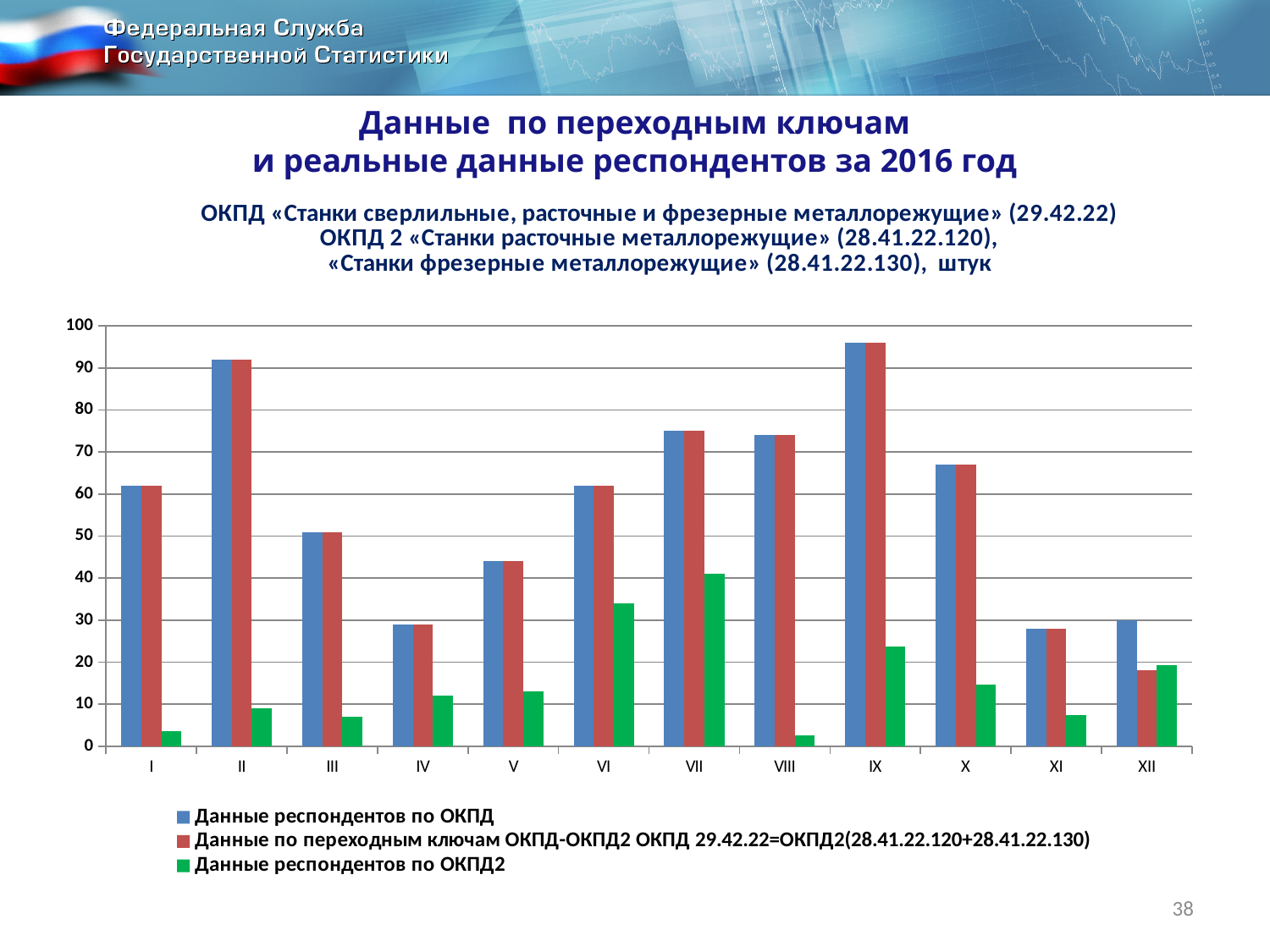
Is the value for "Данные респондентов по ОКПД" in month IX greater or less than 90? greater Is the value for "Данные респондентов по ОКПД2" in month VII greater or less than 30? greater Is the value for "Данные респондентов по ОКПД" in month V greater or less than 50? less Do the values for "Данные респондентов по ОКПД" rise or fall from month IX to month XI? fall How many series does the legend list? 3 Which is larger for "Данные респондентов по ОКПД2": month VI or month IX? month VI In which month is the value for "Данные респондентов по ОКПД" highest? IX In which month is the value for "Данные респондентов по ОКПД2" highest? VII What kind of chart is shown on the slide? bar chart In month XII, which series has the larger value: "Данные респондентов по ОКПД" or "Данные по переходным ключам ОКПД-ОКПД2"? Данные респондентов по ОКПД How many categories are shown on the x axis? 12